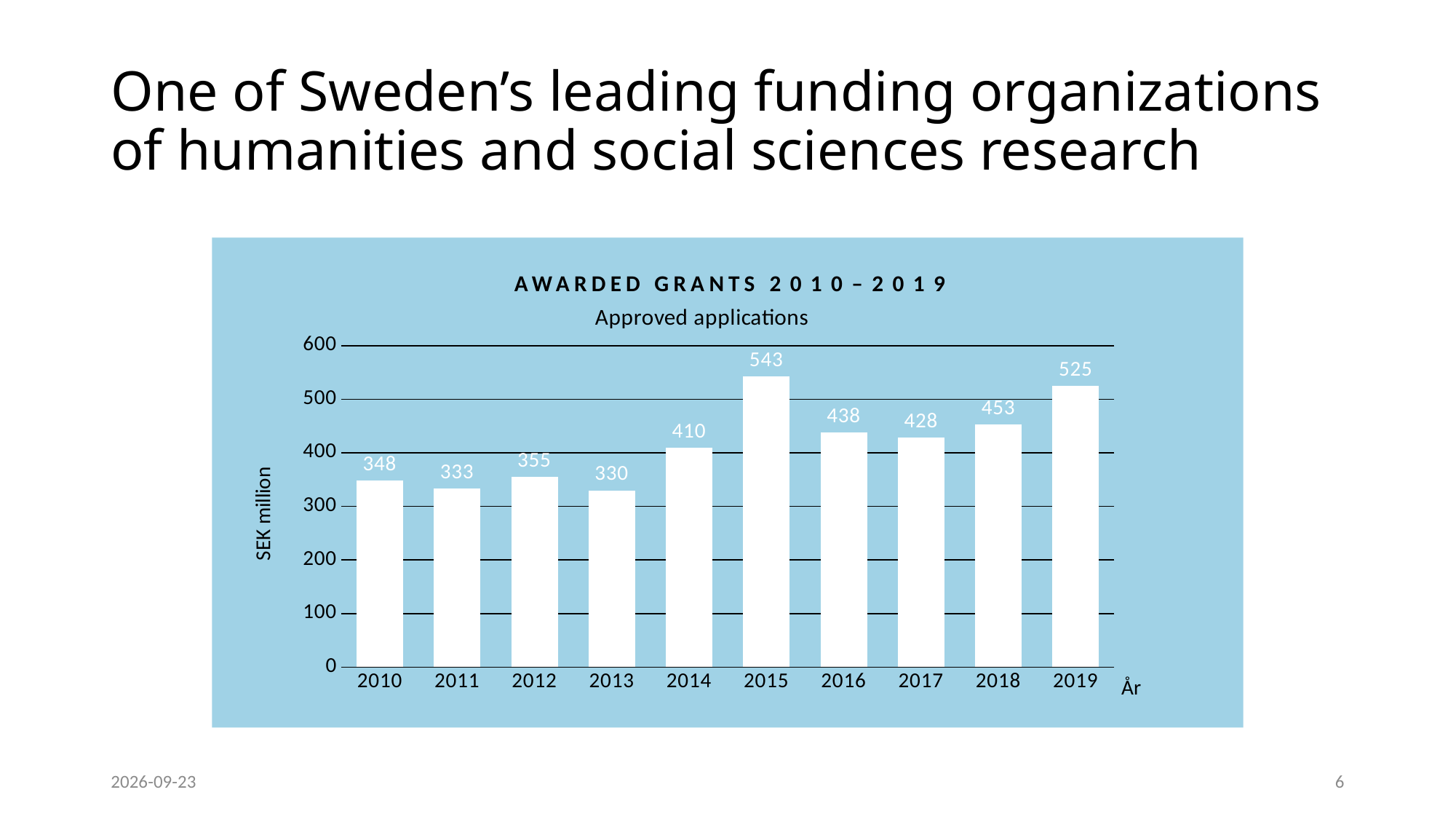
What is the label on the y axis? SEK million What is the title of the chart? AWARDED GRANTS 2010–2019 Which year has the lowest value? 2013 Is the value for 2018 greater or less than 400? greater What is the value for 2013? 330 What is the difference between the values for 2015 and 2014? 133 What is the value for 2019? 525 What is the value for 2015? 543 What kind of chart is shown? bar chart How many years are shown on the x axis? 10 Which is larger, the value for 2016 or the value for 2017? 2016 Which year has the highest value? 2015